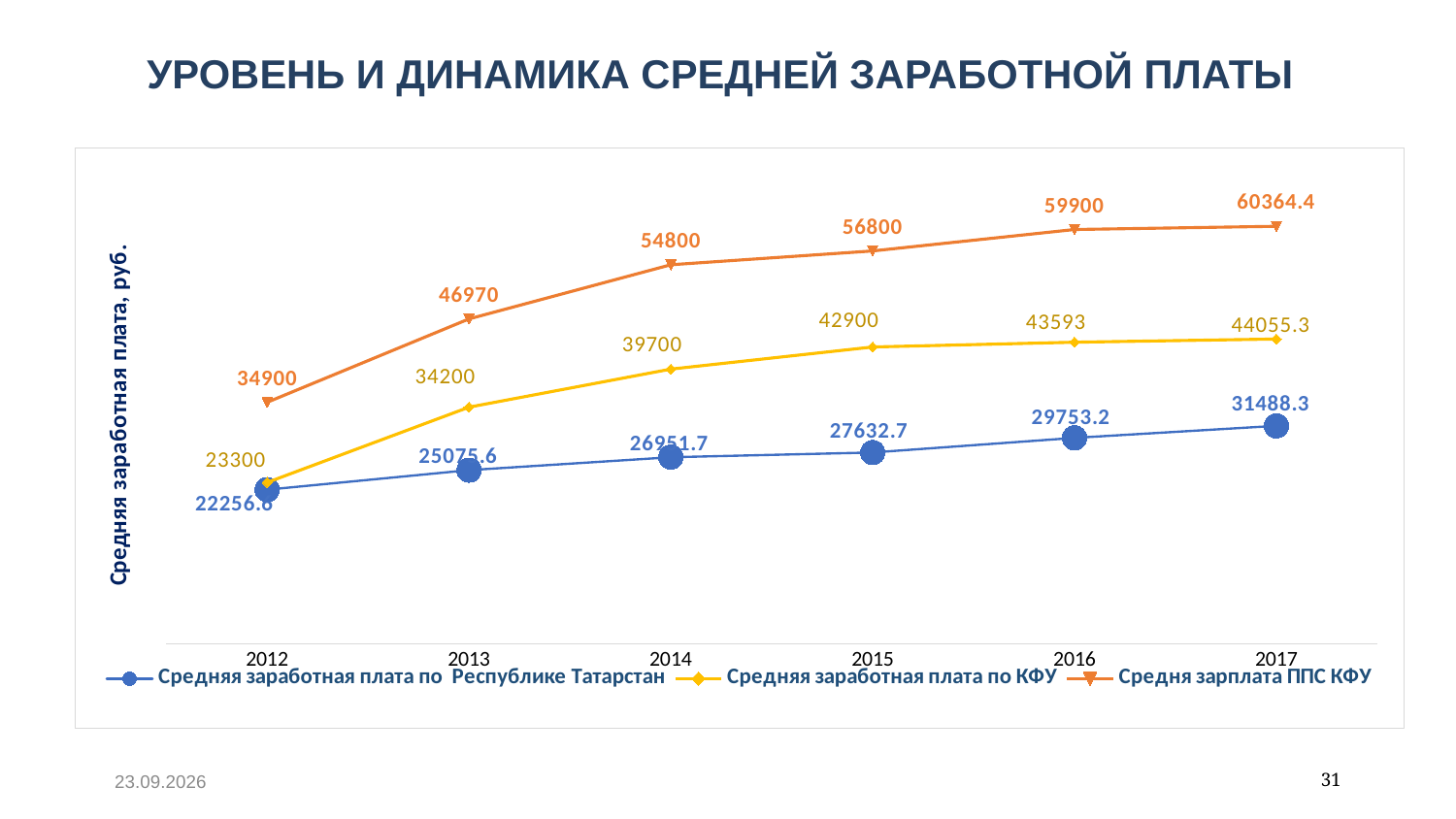
In which year is Средняя заработная плата по КФУ highest? 2017 In which year is Средня зарплата ППС КФУ lowest? 2012 Which is larger in 2013: Средняя заработная плата по КФУ or Средняя заработная плата по Республике Татарстан? Средняя заработная плата по КФУ What kind of chart is shown on the slide? line chart What is the value for Средня зарплата ППС КФУ in 2017? 60364.4 What is the difference between Средня зарплата ППС КФУ and Средняя заработная плата по КФУ in 2015? 13900 What is the value for Средняя заработная плата по Республике Татарстан in 2016? 29753.2 Do the values for Средняя заработная плата по Республике Татарстан rise or fall from 2012 to 2017? rise How many series does the legend list? 3 What is the value for Средня зарплата ППС КФУ in 2013? 46970 What is the value for Средняя заработная плата по КФУ in 2014? 39700 How many years are shown on the x axis? 6